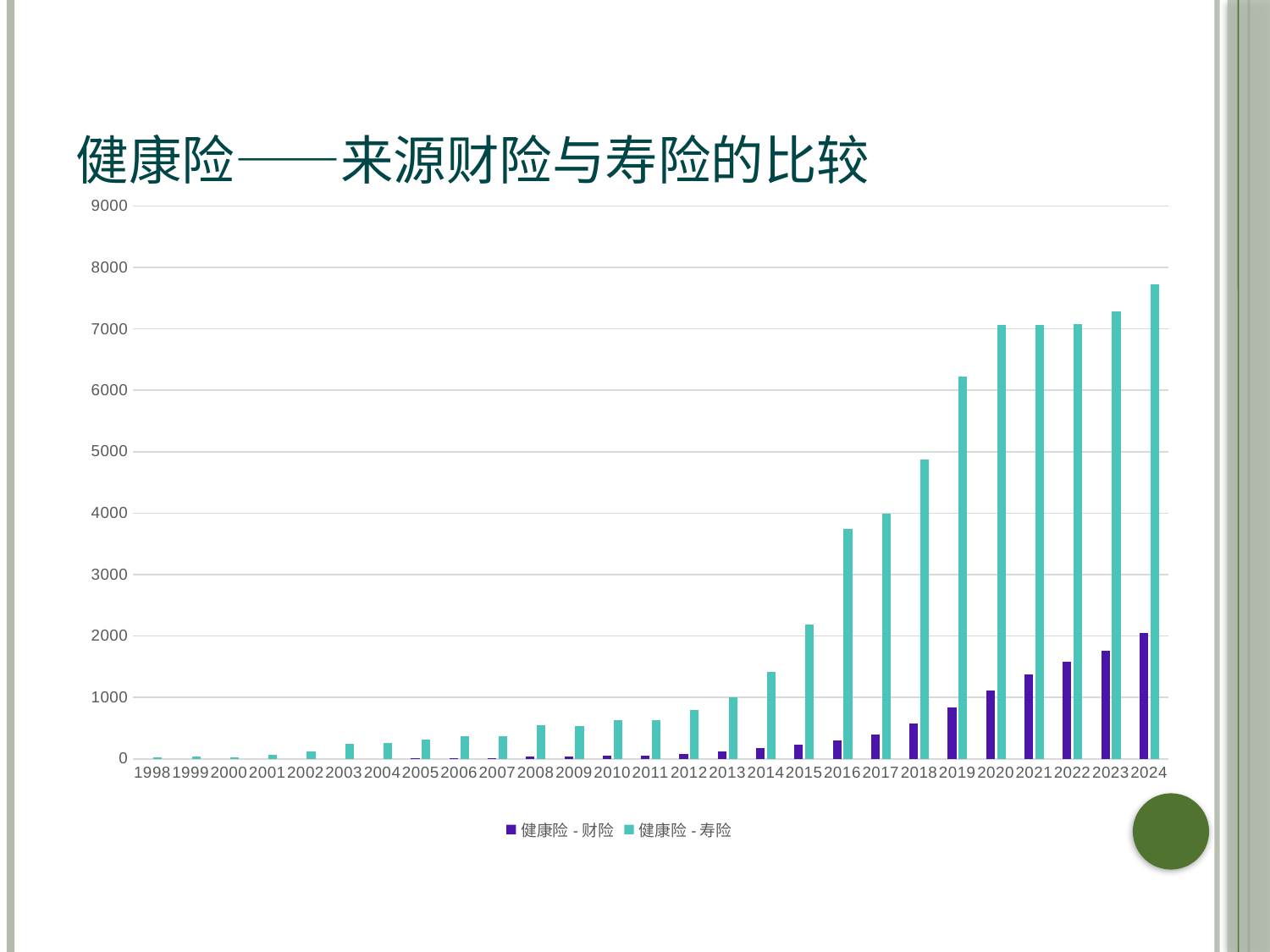
What kind of chart is shown on the slide? bar chart Which year has the highest value for 健康险 - 财险? 2024 In 2024, which series has the larger value, 健康险 - 财险 or 健康险 - 寿险? 健康险 - 寿险 Which year has the highest value for 健康险 - 寿险? 2024 Do the values for 健康险 - 寿险 generally rise or fall from 1998 to 2024? rise Is the value for 健康险 - 寿险 in 2019 greater or less than 6000? greater Is the value for 健康险 - 财险 in 2023 greater or less than 2000? less Is the value for 健康险 - 寿险 in 2024 greater or less than 7000? greater What is the title of the chart on the slide? 健康险——来源财险与寿险的比较 How many years are shown along the x axis? 27 How many series does the legend list? 2